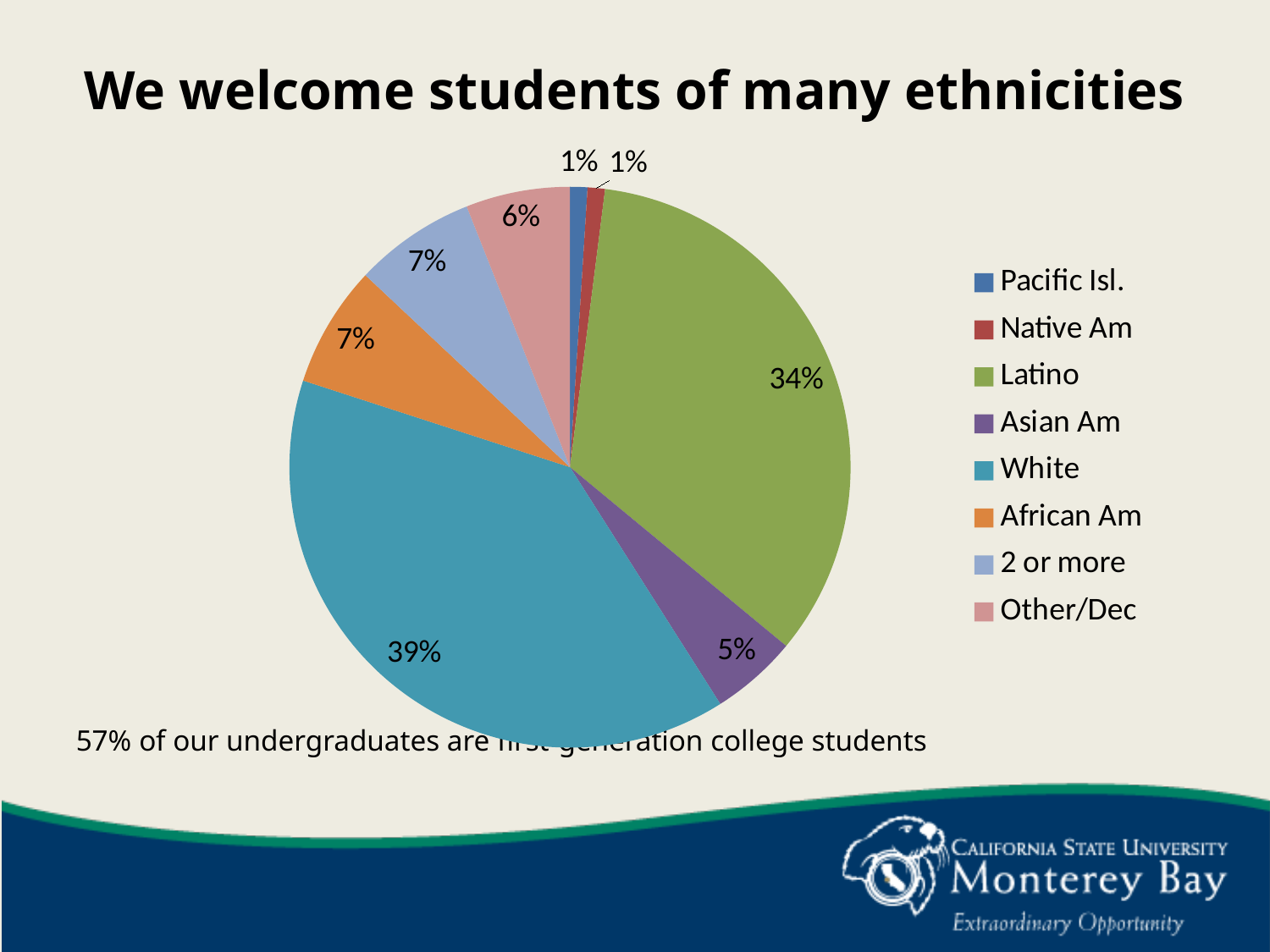
What percentage of students are in the Other/Dec category? 6% What colour is the Latino slice in the pie chart? green What percentage of students are Asian Am? 5% Which ethnicity has the largest share of the pie? White What is the combined share of the Pacific Isl. and Native Am slices? 2% What percentage of students are Latino? 34% How many categories does the pie chart have? 8 What type of chart is shown on the slide? pie chart What is the difference in percentage points between the White and Latino slices? 5 What percentage of students are African Am? 7% Which slice is larger, Asian Am or Other/Dec? Other/Dec What percentage of students are White? 39%